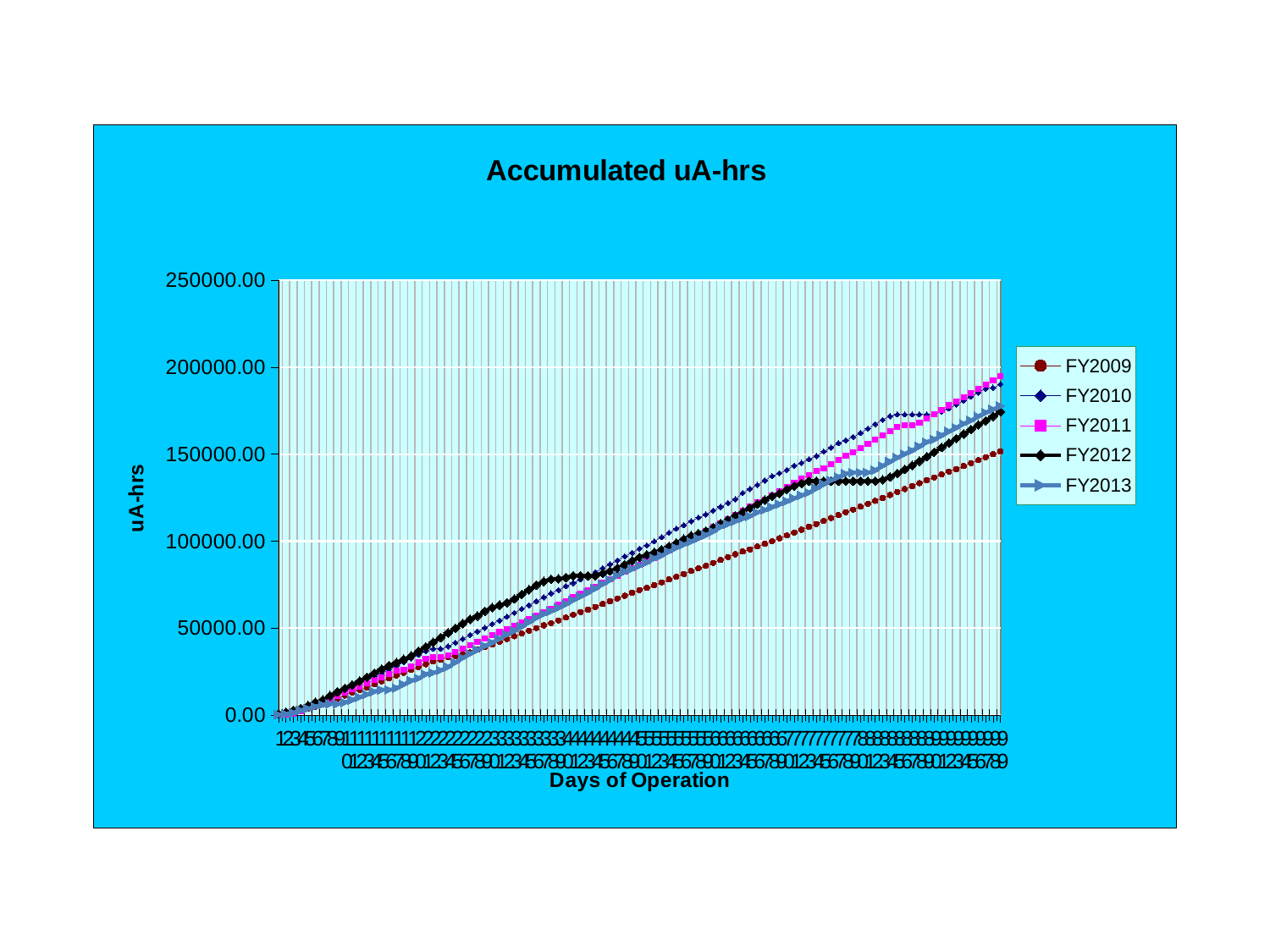
How many series does the legend list? 5 What is the title of the chart? Accumulated uA-hrs Is the final value for FY2012 greater or less than 200000.00? less Do the accumulated uA-hrs values rise or fall as the days of operation increase? rise At the final day of operation, which is larger: FY2009 or FY2011? FY2011 Which series is lowest at the end of the Days of Operation axis? FY2009 Is the final value for FY2011 greater or less than 150000.00? greater What is the label of the y axis? uA-hrs Is the final value for FY2009 greater or less than 200000.00? less Which series is highest at the final day of operation? FY2011 What kind of chart is shown on the slide? line chart